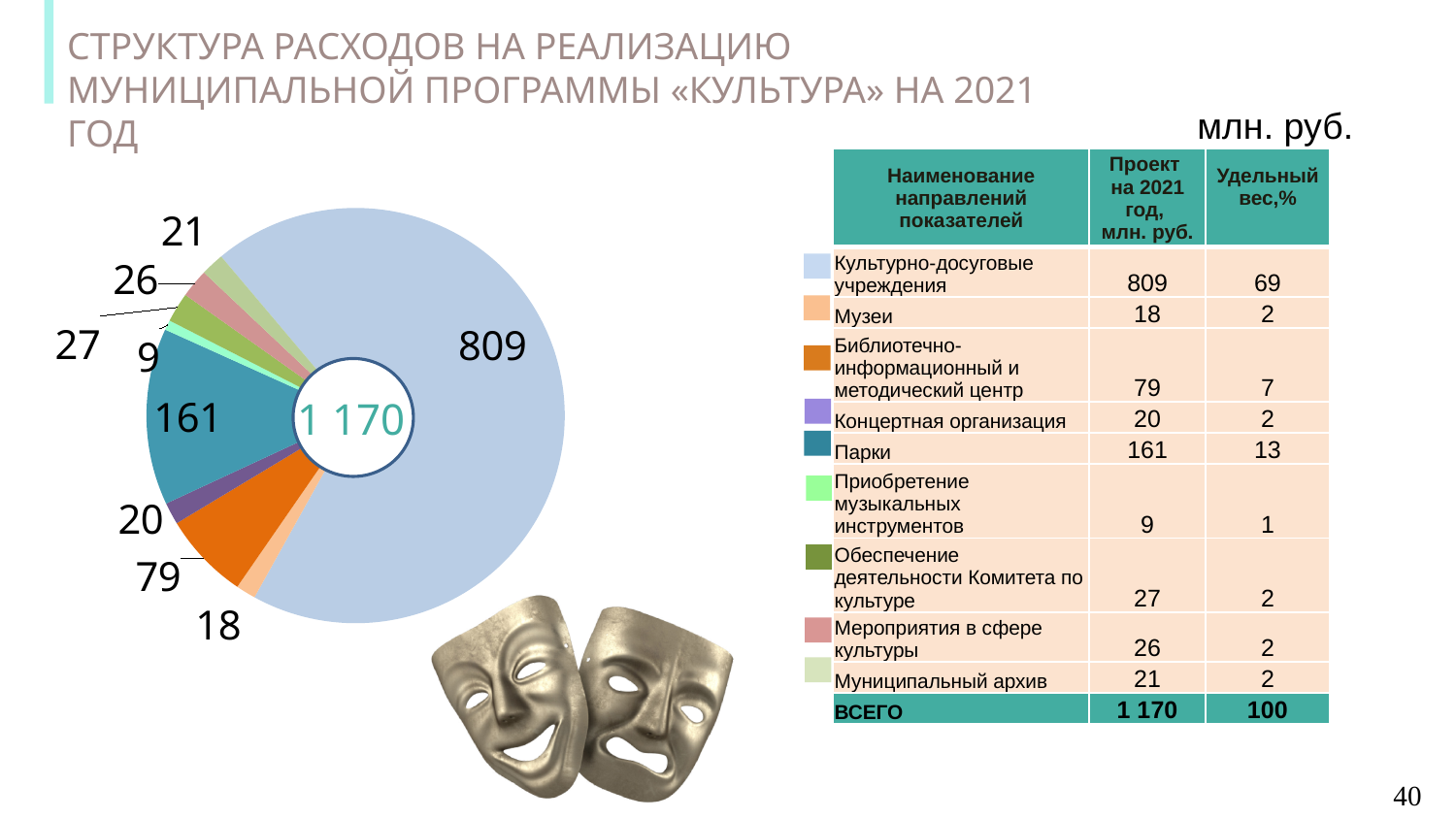
What is the value of the smallest slice of the pie chart? 9 What is the value of the largest slice of the pie chart? 809 What is the difference between the values for Парки and Библиотечно-информационный и методический центр in the pie chart? 82 What is the value shown for Библиотечно-информационный и методический центр in the pie chart? 79 Which is larger in the pie chart, the value for Мероприятия в сфере культуры or the value for Муниципальный архив? Мероприятия в сфере культуры Which category has the smallest slice in the pie chart? Приобретение музыкальных инструментов Which category has the largest slice in the pie chart? Культурно-досуговые учреждения What total value is shown in the centre of the pie chart? 1 170 What share of the total does Культурно-досуговые учреждения account for, according to the slide? 69% What kind of chart is shown on the slide? pie chart How many slices does the pie chart have? 9 What is the value shown for Парки in the pie chart? 161